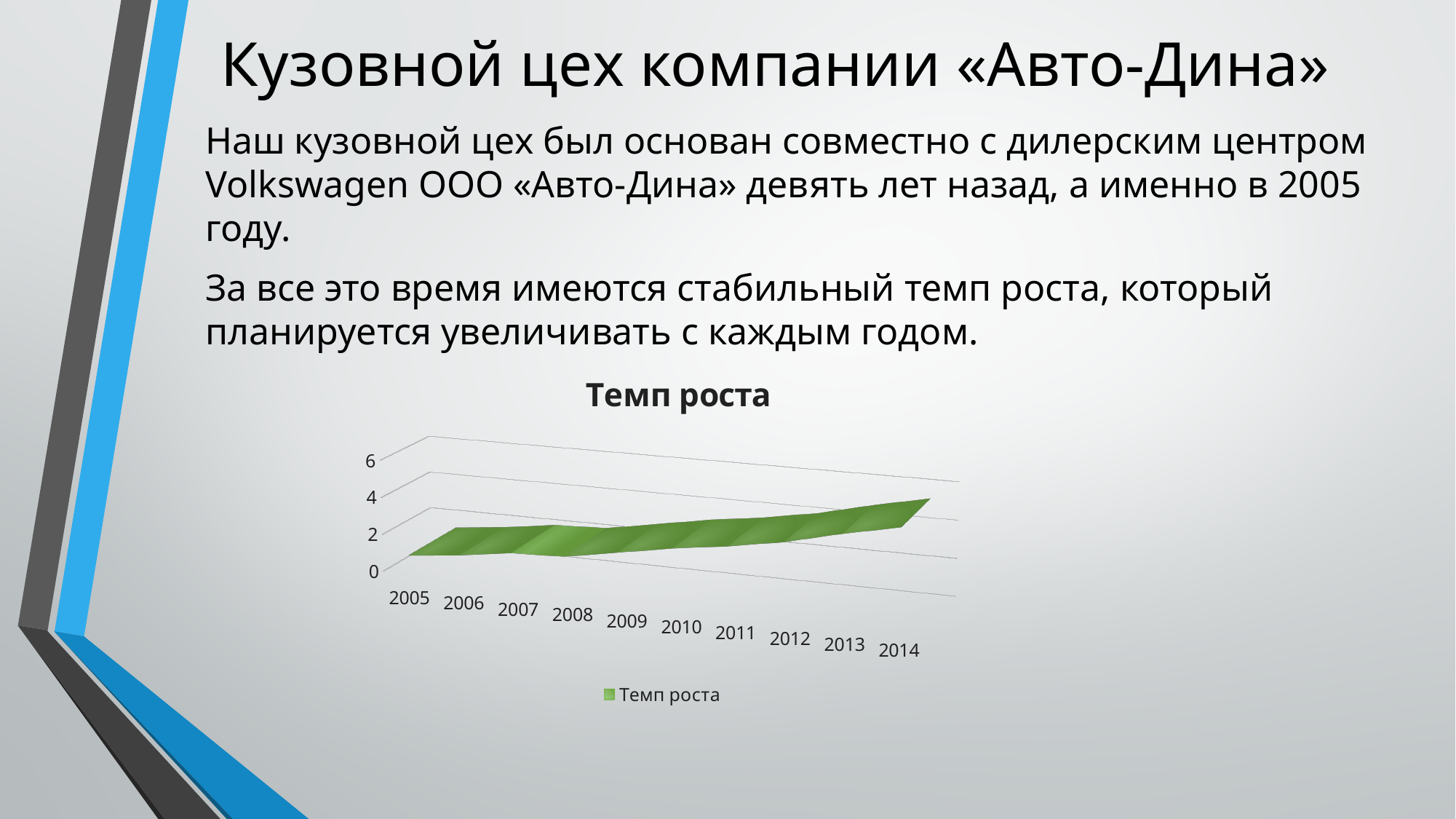
Which year has the highest value in the chart? 2014 What is the first year shown on the x axis of the chart? 2005 How many years are shown on the x axis of the chart? 10 What is the name of the series in the chart legend? Темп роста Which is larger, the value for 2014 or the value for 2005? 2014 What kind of chart is shown on the slide? 3D line chart How many series does the chart legend list? 1 What is the title of the chart? Темп роста Do the values in the chart generally rise or fall from 2005 to 2014? rise What is the highest value shown on the y axis of the chart? 6 Is the value for 2014 greater or less than 2? greater Is the value for 2005 greater or less than 4? less